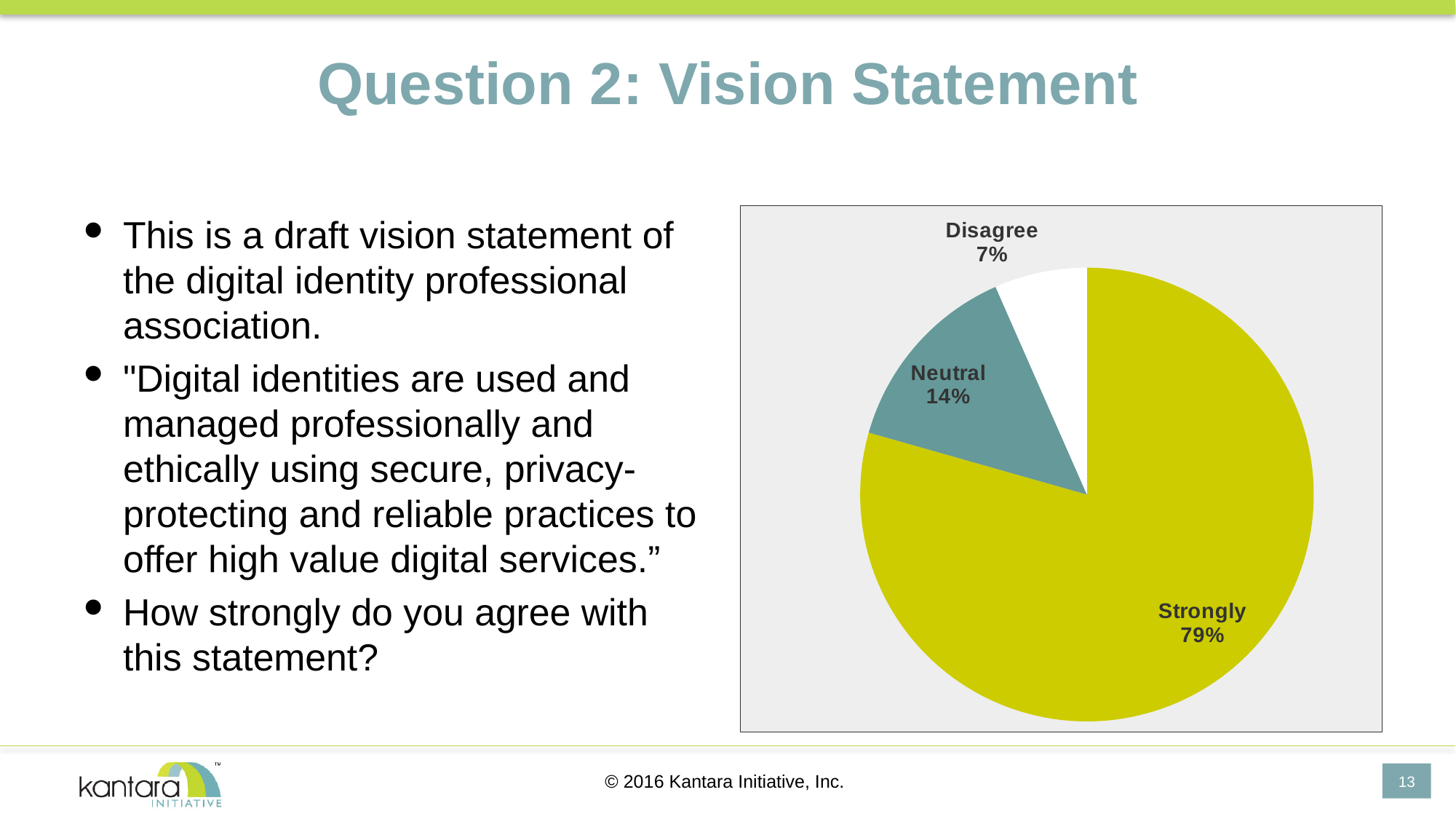
Which slice of the pie is the largest? Strongly What is the difference in percentage points between the Neutral and Disagree slices? 7 What share of the pie is labelled Disagree? 7% What kind of chart is shown on the slide? pie chart What share of the pie is labelled Neutral? 14% What is the difference in percentage points between the Strongly and Neutral slices? 65 What share of the pie is labelled Strongly? 79% How many slices does the pie chart have? 3 Which slice of the pie is the smallest? Disagree What colour is the Strongly slice of the pie? yellow-green What colour is the Neutral slice of the pie? teal Which is larger, the Neutral slice or the Disagree slice? Neutral